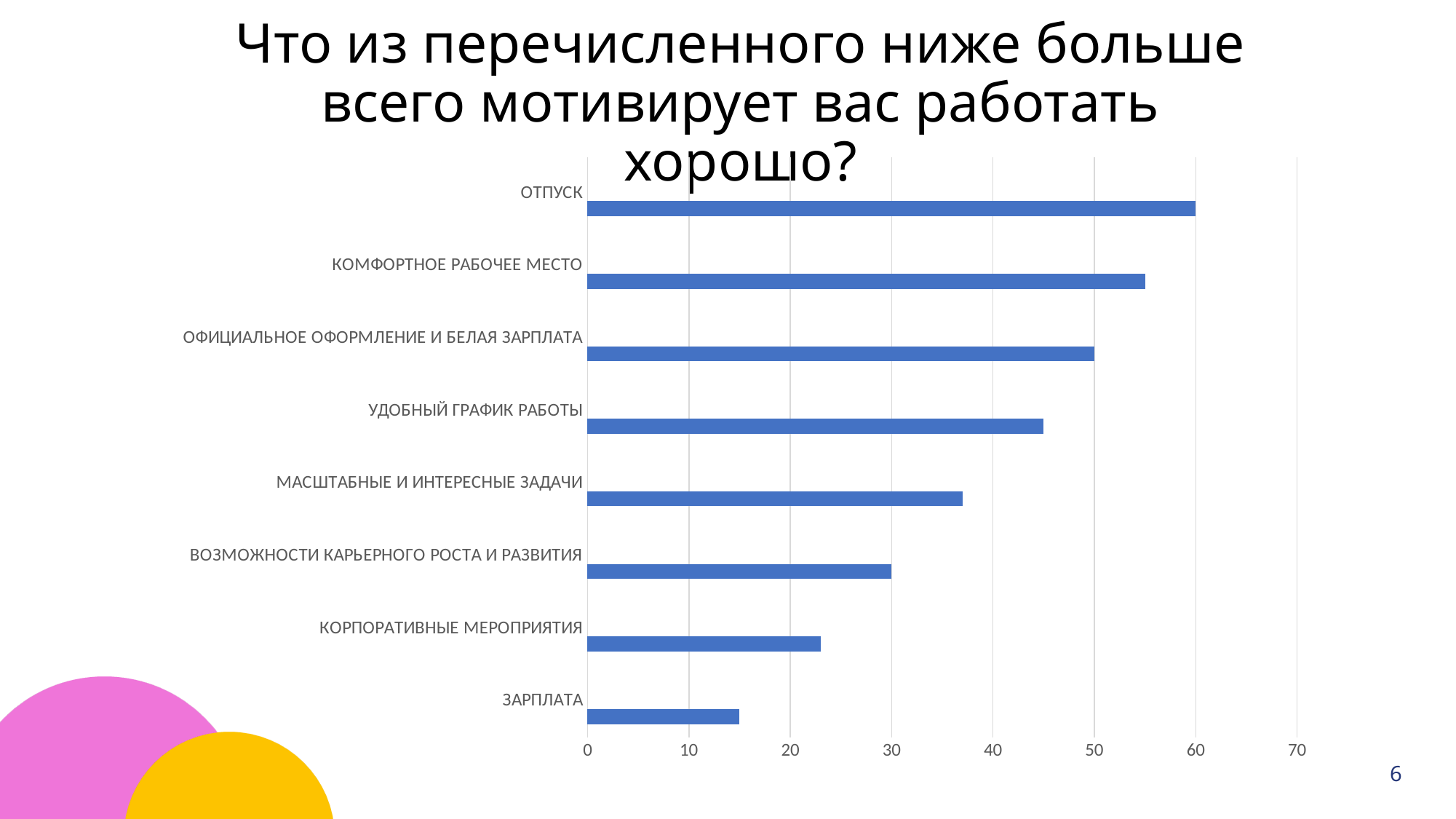
What is the value for ОФИЦИАЛЬНОЕ ОФОРМЛЕНИЕ И БЕЛАЯ ЗАРПЛАТА? 50 Which category has the lowest value? ЗАРПЛАТА Is the value for КОМФОРТНОЕ РАБОЧЕЕ МЕСТО greater or less than 50? greater Which category has the highest value? ОТПУСК Is the value for КОРПОРАТИВНЫЕ МЕРОПРИЯТИЯ greater or less than 30? less What is the title of the slide containing the chart? Что из перечисленного ниже больше всего мотивирует вас работать хорошо? What is the value for ВОЗМОЖНОСТИ КАРЬЕРНОГО РОСТА И РАЗВИТИЯ? 30 What kind of chart is shown on the slide? bar chart How many categories are plotted in the chart? 8 Which is larger, the value for УДОБНЫЙ ГРАФИК РАБОТЫ or the value for ЗАРПЛАТА? УДОБНЫЙ ГРАФИК РАБОТЫ What is the value for ОТПУСК? 60 Is the value for МАСШТАБНЫЕ И ИНТЕРЕСНЫЕ ЗАДАЧИ greater or less than 40? less